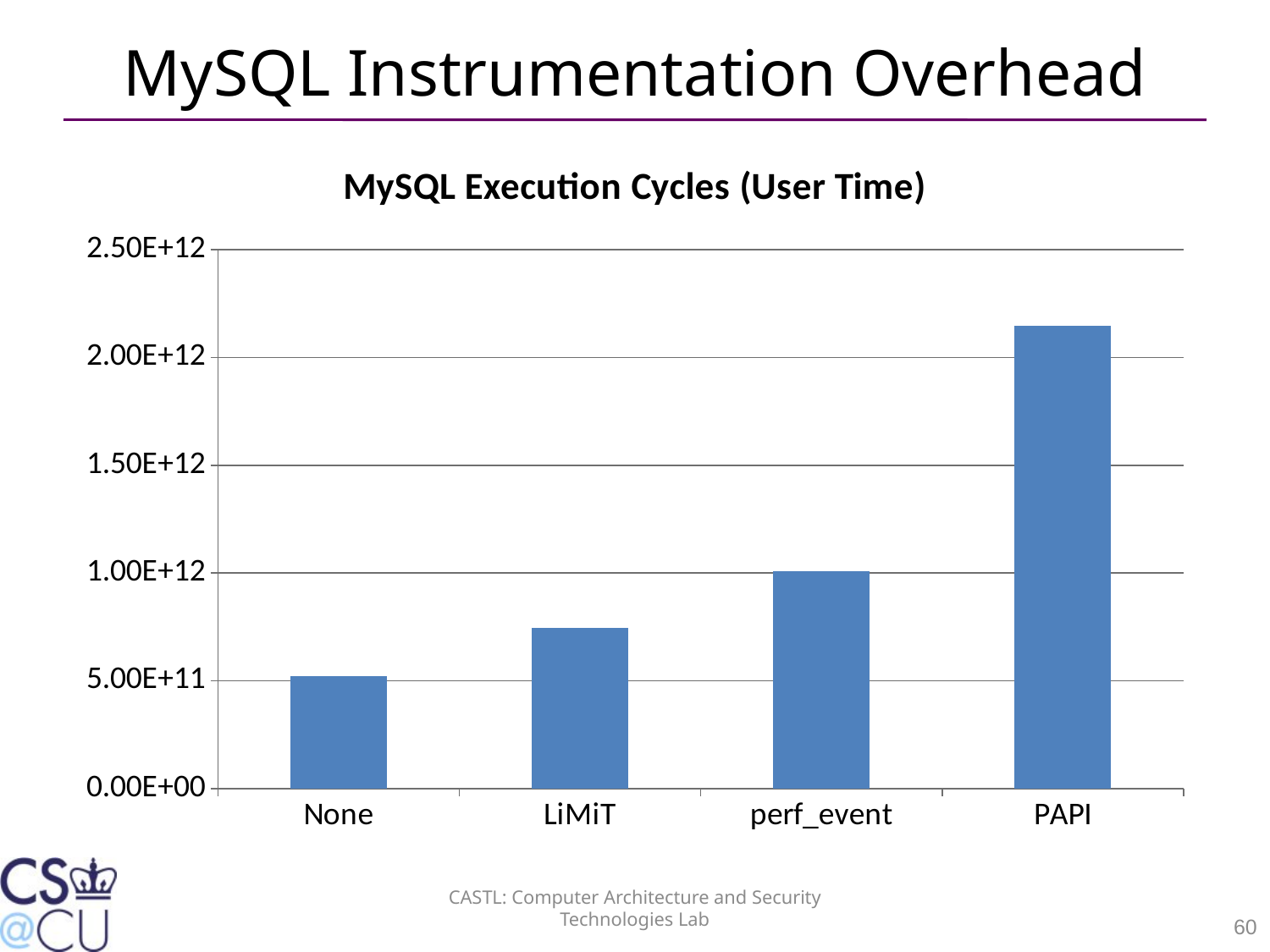
Is the value for LiMiT greater or less than 1.00E+12? less Which has a larger value, PAPI or LiMiT? PAPI How many categories are shown on the x axis of the chart? 4 Is the value for perf_event greater or less than 1.50E+12? less Is the value for None greater or less than 1.00E+12? less Do the values rise or fall moving from None to PAPI along the x axis? rise Which has a larger value, perf_event or None? perf_event Which category has the highest value in the chart? PAPI Which category has the lowest value in the chart? None What kind of chart is shown on the slide? bar chart What is the title of the chart? MySQL Execution Cycles (User Time)